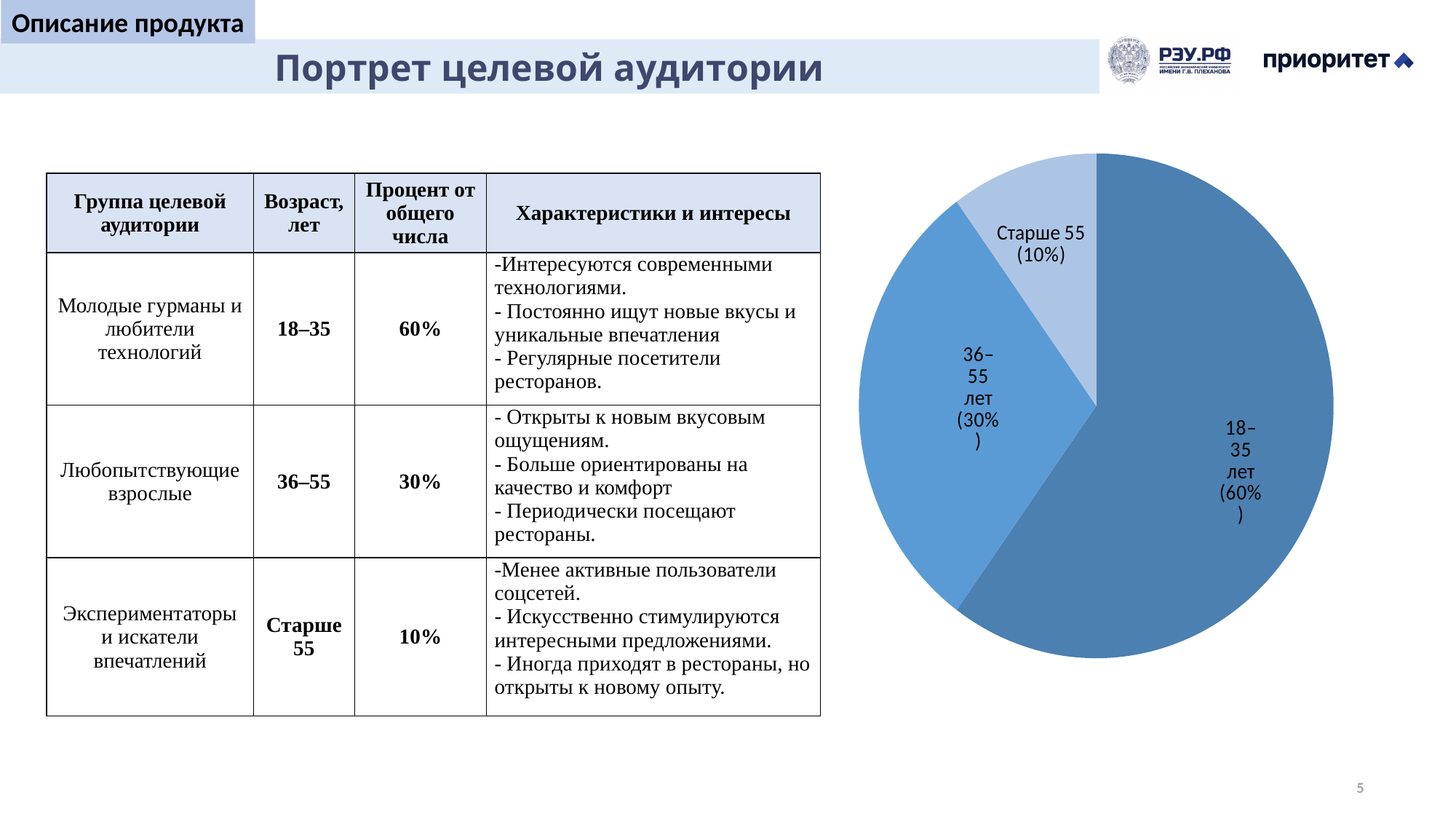
What share of the pie does the 18–35 лет slice represent? 60% What share of the pie does the Старше 55 slice represent? 10% Which slice of the pie chart is drawn in the lightest shade of blue? Старше 55 Which slice is larger in the pie chart: 36–55 лет or Старше 55? 36–55 лет What share of the pie does the 36–55 лет slice represent? 30% How many slices does the pie chart have? 3 Which age group has the largest slice in the pie chart? 18–35 лет What is the difference in percentage points between the 18–35 лет slice and the 36–55 лет slice? 30 Is the share for the 18–35 лет slice greater or less than 50%? greater What is the difference in percentage points between the 36–55 лет slice and the Старше 55 slice? 20 Which age group has the smallest slice in the pie chart? Старше 55 What kind of chart is shown on the right side of the slide? pie chart